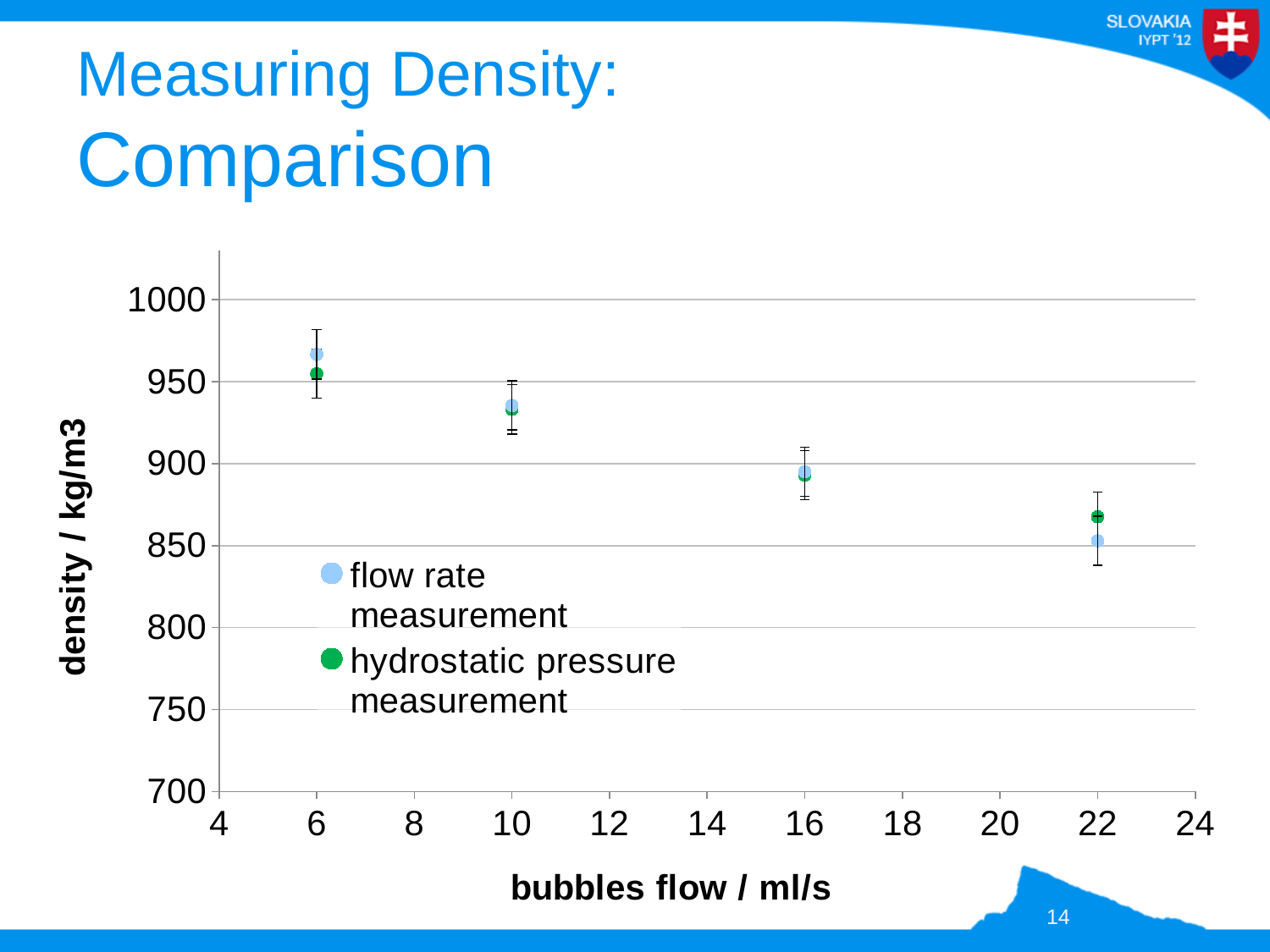
What kind of chart is shown on the slide? scatter chart At which bubbles flow value is the hydrostatic pressure measurement density lowest? 22 How many series does the legend list? 2 At which bubbles flow value is the flow rate measurement density highest? 6 At a bubbles flow of 22 ml/s, which series has the higher density: flow rate measurement or hydrostatic pressure measurement? hydrostatic pressure measurement Which series is plotted with green markers? hydrostatic pressure measurement Do the density values rise or fall as bubbles flow increases? fall What is the label of the y axis? density / kg/m3 Is the hydrostatic pressure measurement density at a bubbles flow of 22 ml/s greater or less than 850? greater How many bubbles flow values have data points plotted? 4 Is the flow rate measurement density at a bubbles flow of 6 ml/s greater or less than 950? greater Is the flow rate measurement density at a bubbles flow of 10 ml/s greater or less than 950? less